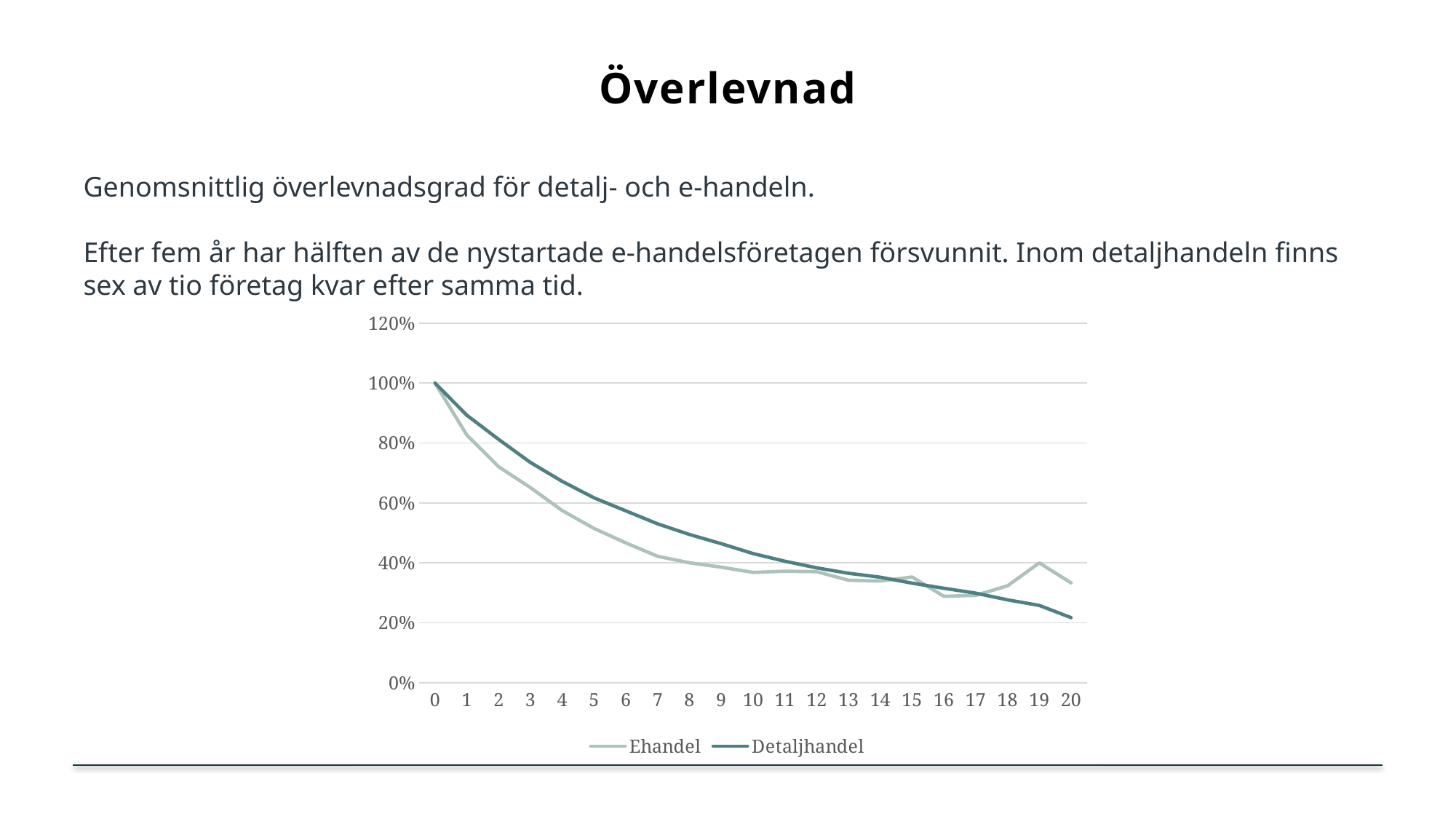
What kind of chart is shown on the slide? line chart What is the value for Ehandel at year 0? 100% How many points along the x axis does each line have (from 0 to 20)? 21 What are the two series named in the legend? Ehandel and Detaljhandel Is the value for Ehandel at year 1 greater or less than 80%? greater What is the value for Detaljhandel at year 0? 100% How many series does the legend list? 2 Which series has the higher value at year 5, Ehandel or Detaljhandel? Detaljhandel Is the value for Ehandel at year 10 greater or less than 40%? less Which series has the higher value at year 20, Ehandel or Detaljhandel? Ehandel Do the values for Detaljhandel rise or fall from year 0 to year 20? fall Is the value for Detaljhandel at year 3 greater or less than 60%? greater